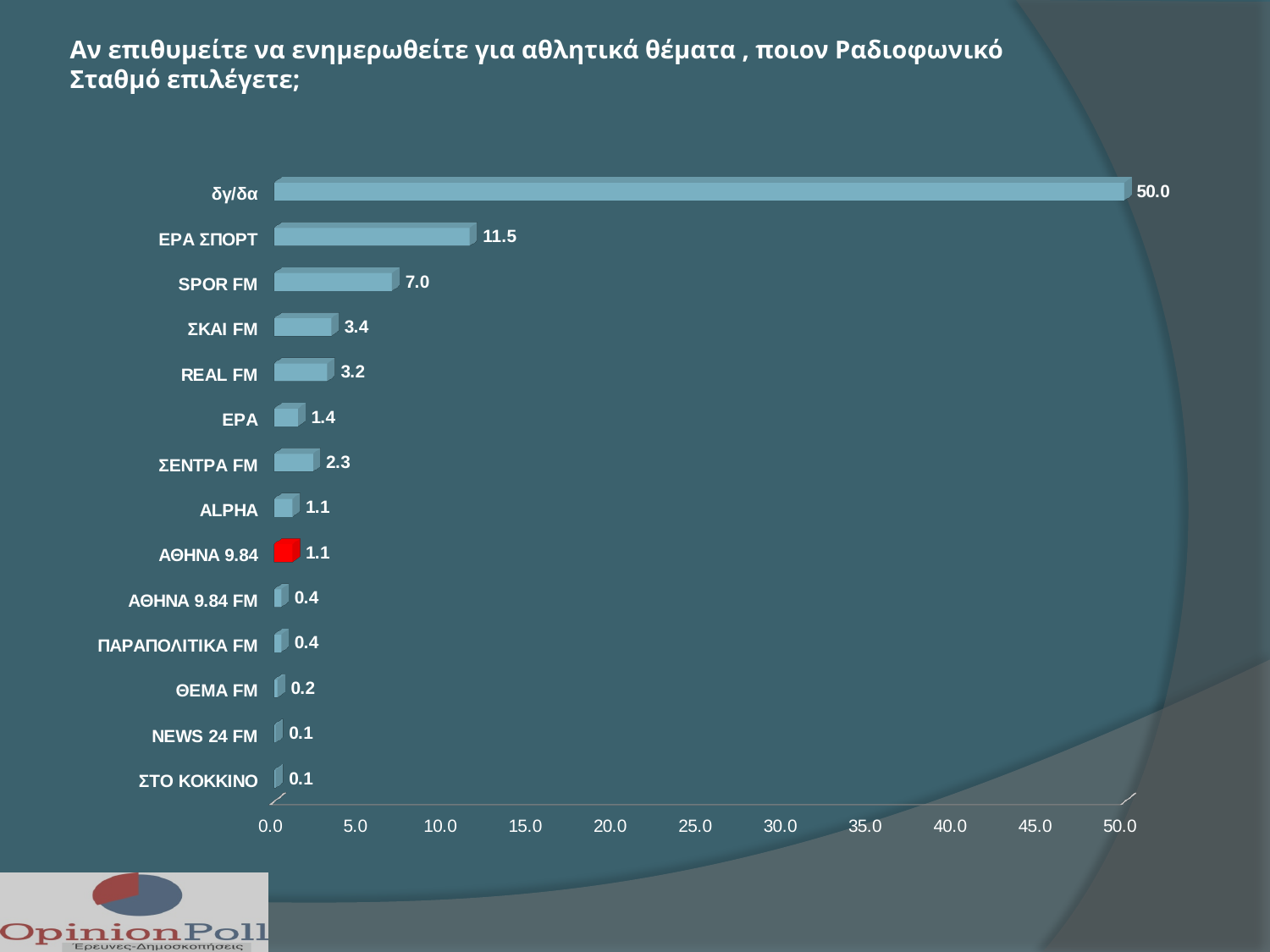
What is the value for ΣΕΝΤΡΑ FM? 2.3 What is the difference between the values for ΕΡΑ ΣΠΟΡΤ and SPOR FM? 4.5 Which bar is coloured red? ΑΘΗΝΑ 9.84 How many categories are shown in the chart? 14 Which is larger, the value for ΕΡΑ or the value for ΣΕΝΤΡΑ FM? ΣΕΝΤΡΑ FM What kind of chart is shown on the slide? bar chart What is the difference between the values for ΣΚΑΙ FM and REAL FM? 0.2 What is the value for ΘΕΜΑ FM? 0.2 Is the value for δγ/δα greater or less than 45.0? greater Which category has the highest value? δγ/δα What is the value for ΕΡΑ ΣΠΟΡΤ? 11.5 What is the value for SPOR FM? 7.0